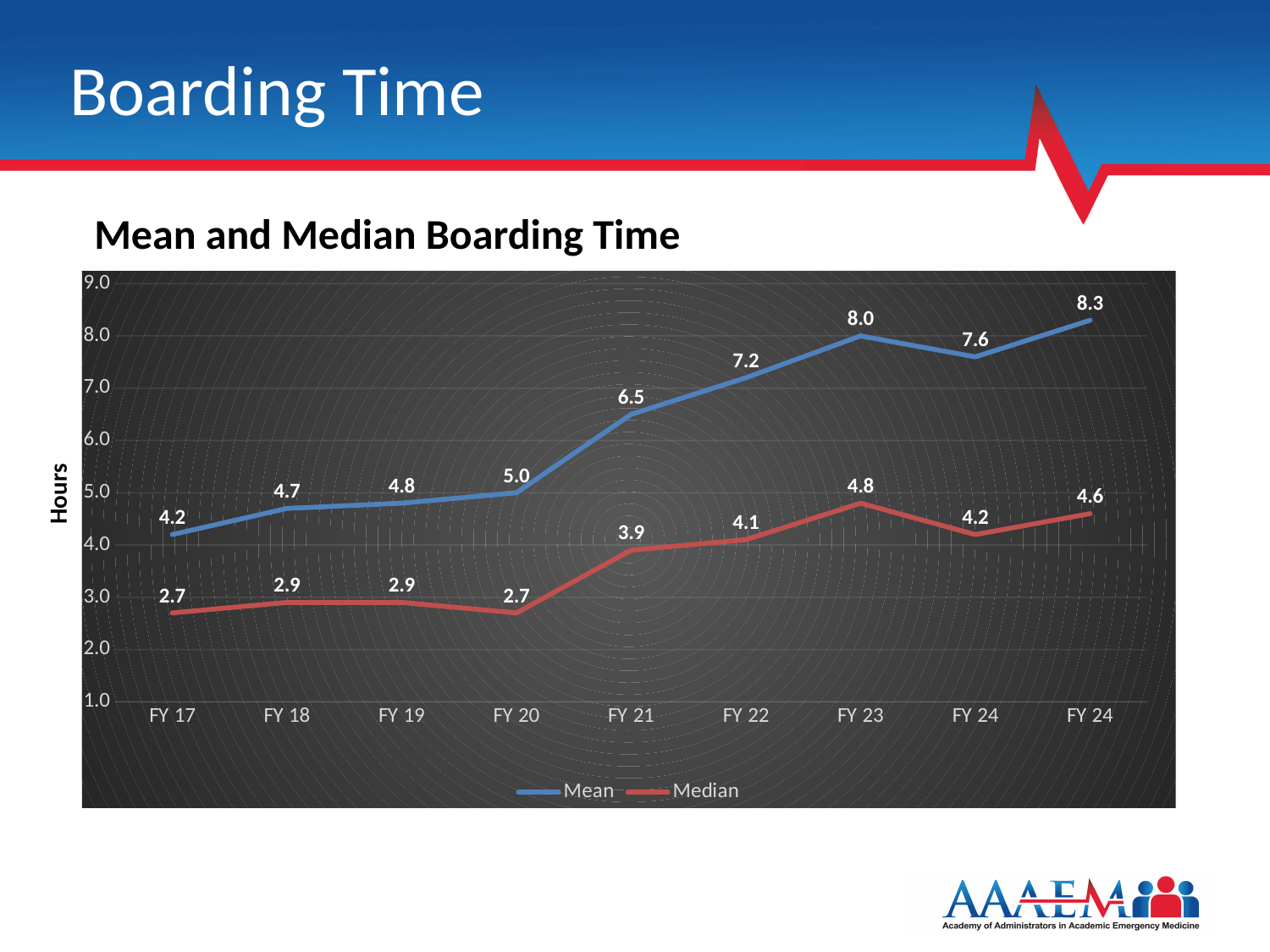
In which fiscal year is the Median boarding time highest? FY 23 Which is larger, the Mean boarding time in FY 19 or in FY 20? FY 20 What is the Mean boarding time for FY 21? 6.5 What is the label on the vertical axis? Hours How many series does the legend list? 2 In which fiscal year is the Mean boarding time lowest? FY 17 Is the Mean boarding time for FY 23 greater or less than 7.0? greater By how much did the Mean boarding time increase from FY 20 to FY 21? 1.5 What kind of chart is shown? line chart What is the difference between the Mean and Median boarding times in FY 22? 3.1 What is the Median boarding time for FY 23? 4.8 How many data points does each line have? 9